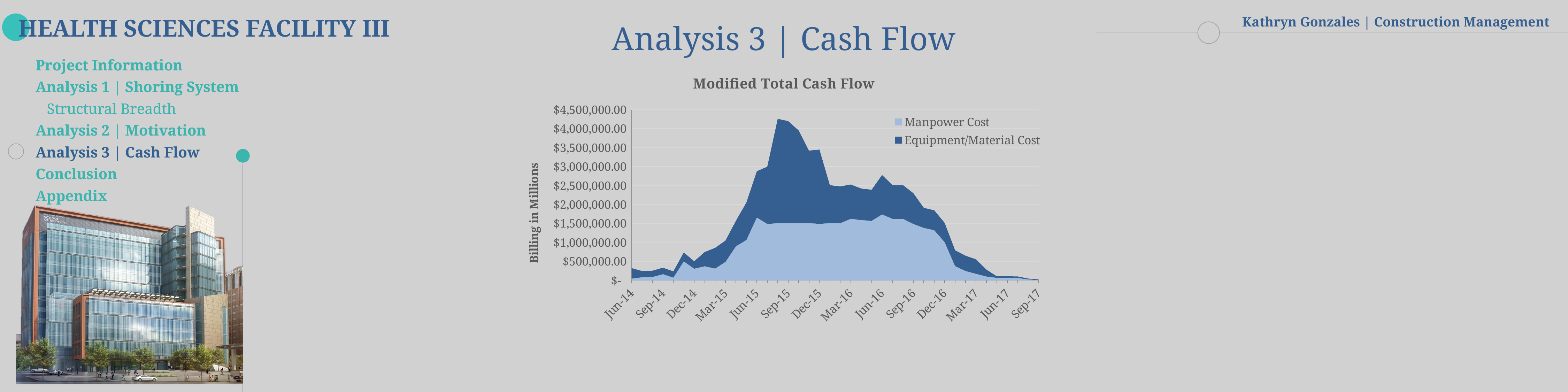
What are the two series named in the legend of the Modified Total Cash Flow chart? Manpower Cost and Equipment/Material Cost Is the total cash flow at Sep-17 greater or less than $500,000.00? less How many month labels are shown along the x axis of the Modified Total Cash Flow chart? 14 Is the total cash flow at Jun-14 greater or less than $500,000.00? less Is the Manpower Cost at Sep-15 greater or less than $1,000,000.00? greater Does the total cash flow rise or fall between Sep-16 and Sep-17? Fall What kind of chart is shown under the title "Modified Total Cash Flow"? Stacked area chart Which is larger at Sep-15, the Manpower Cost or the Equipment/Material Cost? Equipment/Material Cost How many series does the legend of the Modified Total Cash Flow chart list? 2 What is the label on the vertical axis of the Modified Total Cash Flow chart? Billing in Millions